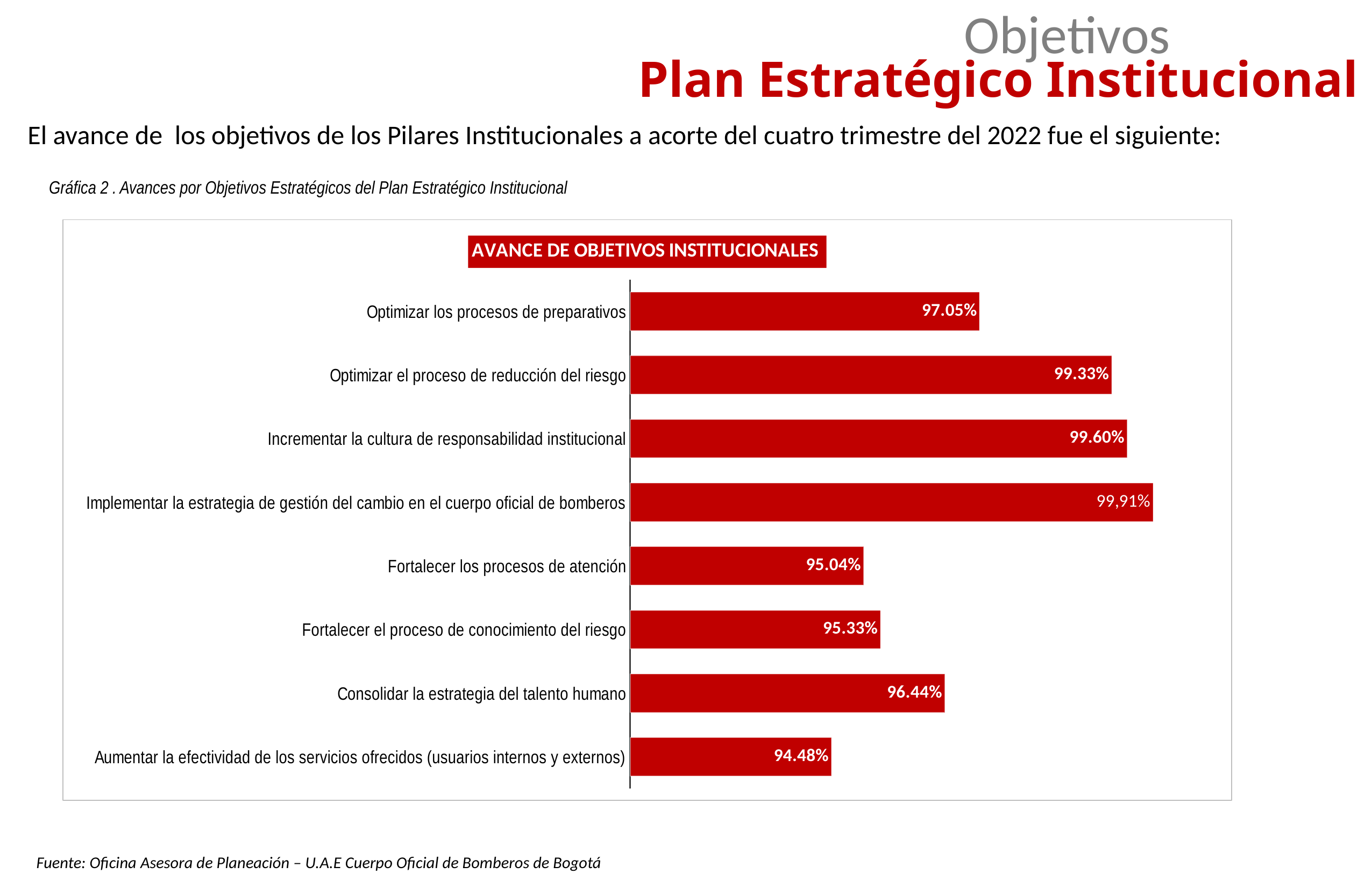
Which objective has the highest value? Implementar la estrategia de gestión del cambio en el cuerpo oficial de bomberos What is the value for "Consolidar la estrategia del talento humano"? 96.44% What is the difference between the values for "Optimizar el proceso de reducción del riesgo" and "Fortalecer el proceso de conocimiento del riesgo"? 4.00% What is the title of the chart? AVANCE DE OBJETIVOS INSTITUCIONALES What is the value for "Optimizar los procesos de preparativos"? 97.05% What is the value for "Implementar la estrategia de gestión del cambio en el cuerpo oficial de bomberos"? 99,91% Which is larger: the value for "Optimizar los procesos de preparativos" or the value for "Consolidar la estrategia del talento humano"? Optimizar los procesos de preparativos What kind of chart is shown on the slide? Bar chart How many objectives are shown in the chart? 8 Which objective has the lowest value? Aumentar la efectividad de los servicios ofrecidos (usuarios internos y externos) What is the value for "Fortalecer los procesos de atención"? 95.04% What colour are the bars in the chart? Red